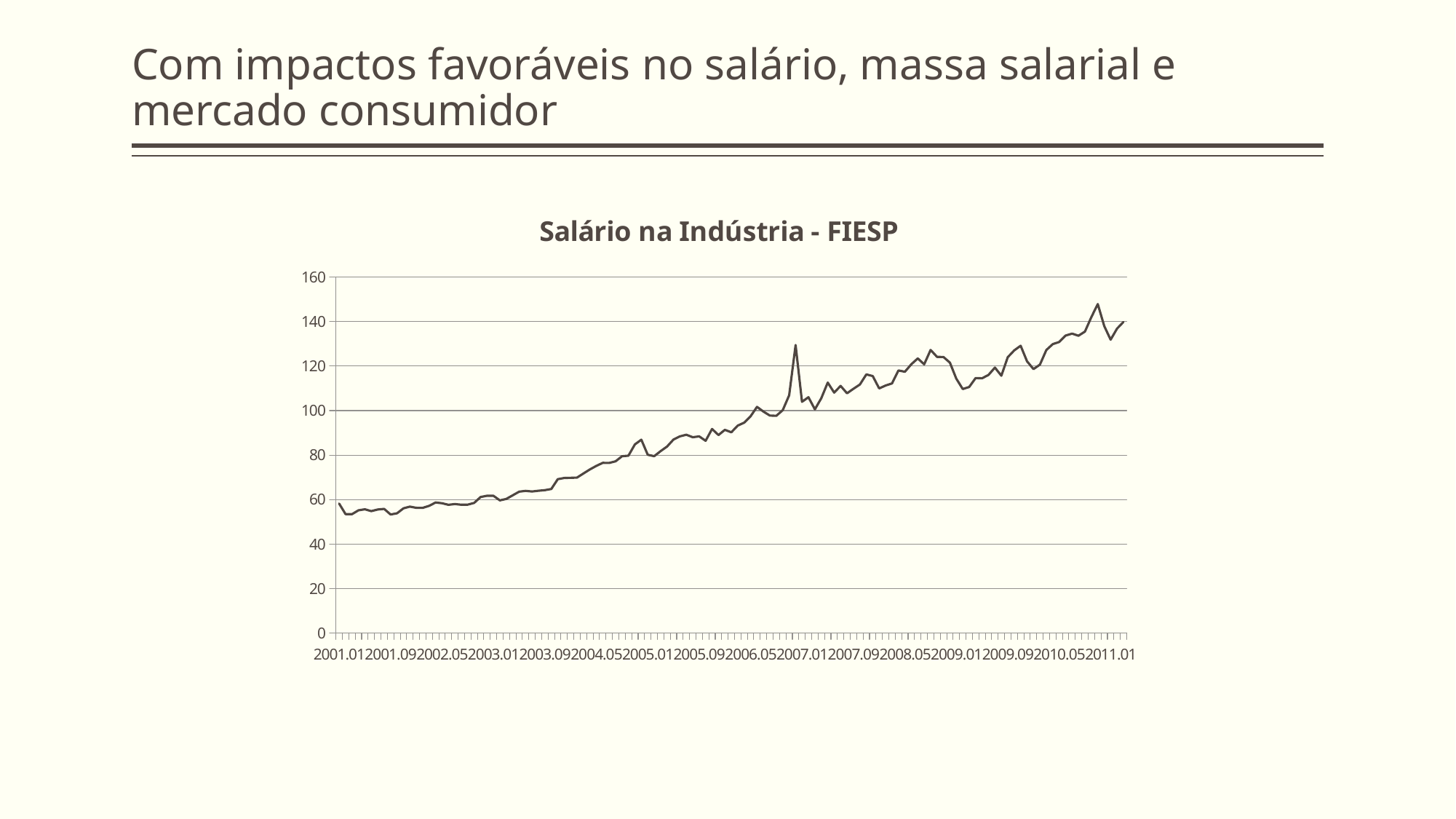
Is the value for 2008.05 greater or less than 100? greater Is the value for 2004.05 greater or less than 100? less Which is larger, the value for 2005.01 or the value for 2009.01? 2009.01 What is the highest value shown on the vertical axis? 160 Is the value for 2001.09 greater or less than 60? less What kind of chart is shown on the slide? line chart What is the title of the chart? Salário na Indústria - FIESP Overall, do the values rise or fall from 2001.01 to 2011.01? rise Which is larger, the value for 2011.01 or the value for 2001.01? 2011.01